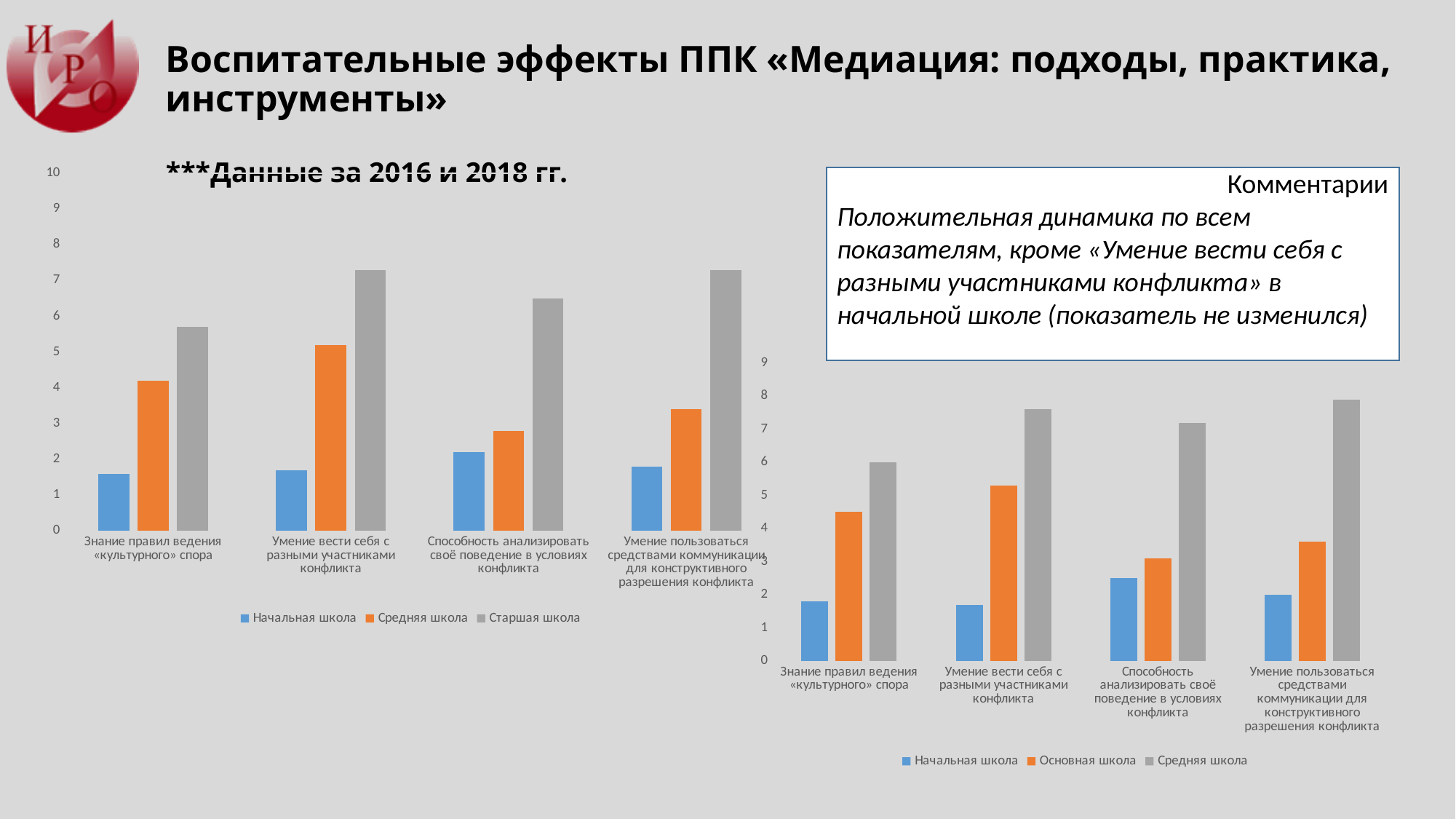
In the right chart, is the value for Основная школа in «Способность анализировать своё поведение в условиях конфликта» greater or less than 4? less In the right chart, which category has the highest value for Начальная школа? Способность анализировать своё поведение в условиях конфликта In the left chart, which category has the highest value for Средняя школа? Умение вести себя с разными участниками конфликта What kind of chart is the left chart on the slide? Bar chart In the left chart, which category has the lowest value for Средняя школа? Способность анализировать своё поведение в условиях конфликта How many categories are shown on the x axis of the right chart? 4 How many series does the legend of the left chart list? 3 In the right chart, which series does the legend list in orange? Основная школа In the right chart, which category has the lowest value for Средняя школа? Знание правил ведения «культурного» спора In the left chart, which is larger for Средняя школа: «Знание правил ведения «культурного» спора» or «Умение пользоваться средствами коммуникации для конструктивного разрешения конфликта»? Знание правил ведения «культурного» спора In the left chart, is the value for Старшая школа in «Знание правил ведения «культурного» спора» greater or less than 5? greater In the left chart, which category has the lowest value for Старшая школа? Знание правил ведения «культурного» спора